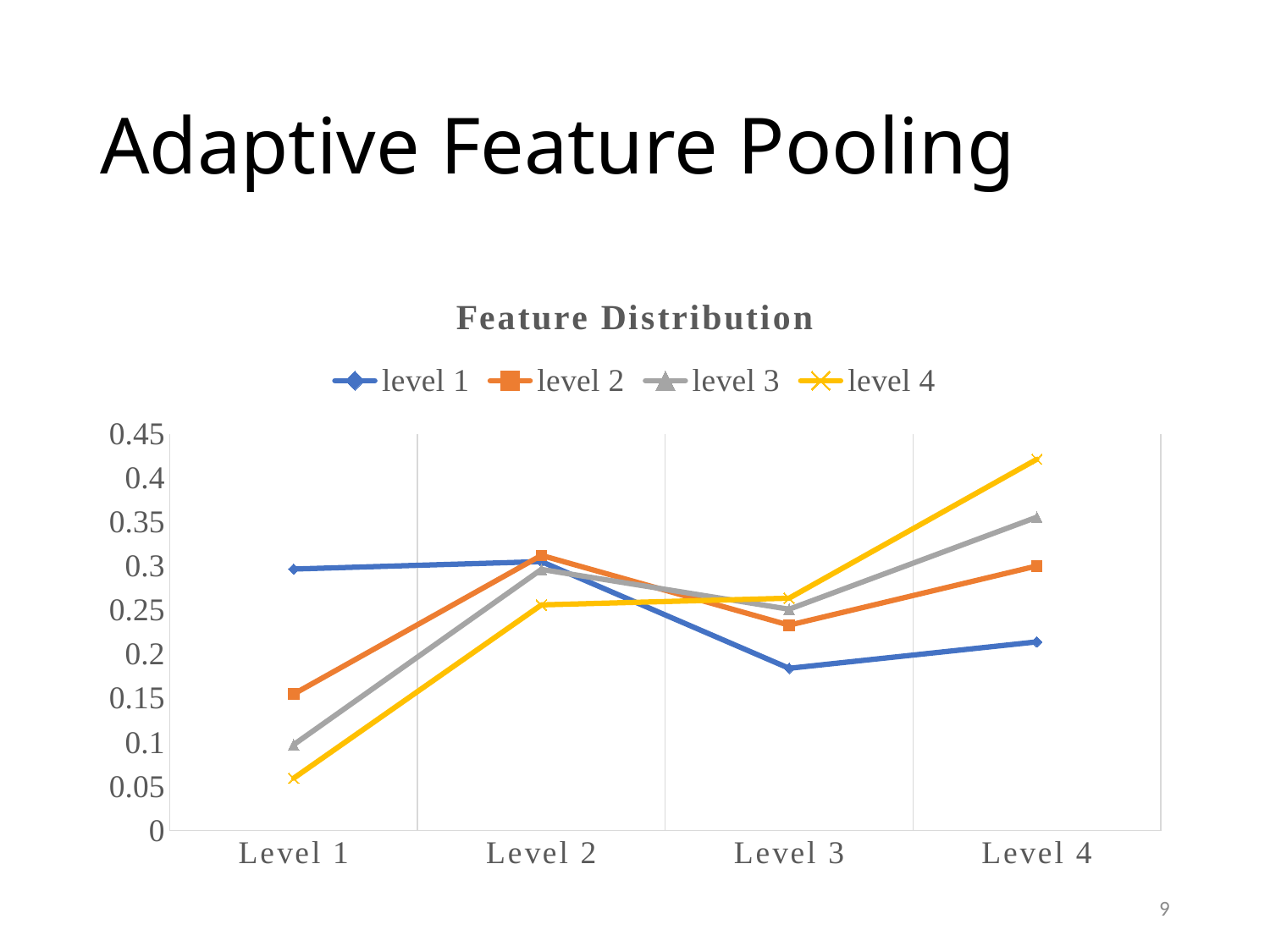
How many series does the legend list? 4 Does the level 4 series rise or fall from Level 1 to Level 4? rises Which series has the lowest value at Level 1? level 4 How many categories are on the x axis? 4 Is the value of level 2 at Level 1 greater or less than 0.2? less Which series has the highest value at Level 4? level 4 Is the value of level 4 at Level 4 greater or less than 0.4? greater Is the value of level 1 at Level 3 greater or less than 0.2? less For the level 3 series, at which category is its value highest? Level 4 What kind of chart is shown on the slide? line chart What is the title of the chart? Feature Distribution At Level 1, which is larger: level 1 or level 2? level 1